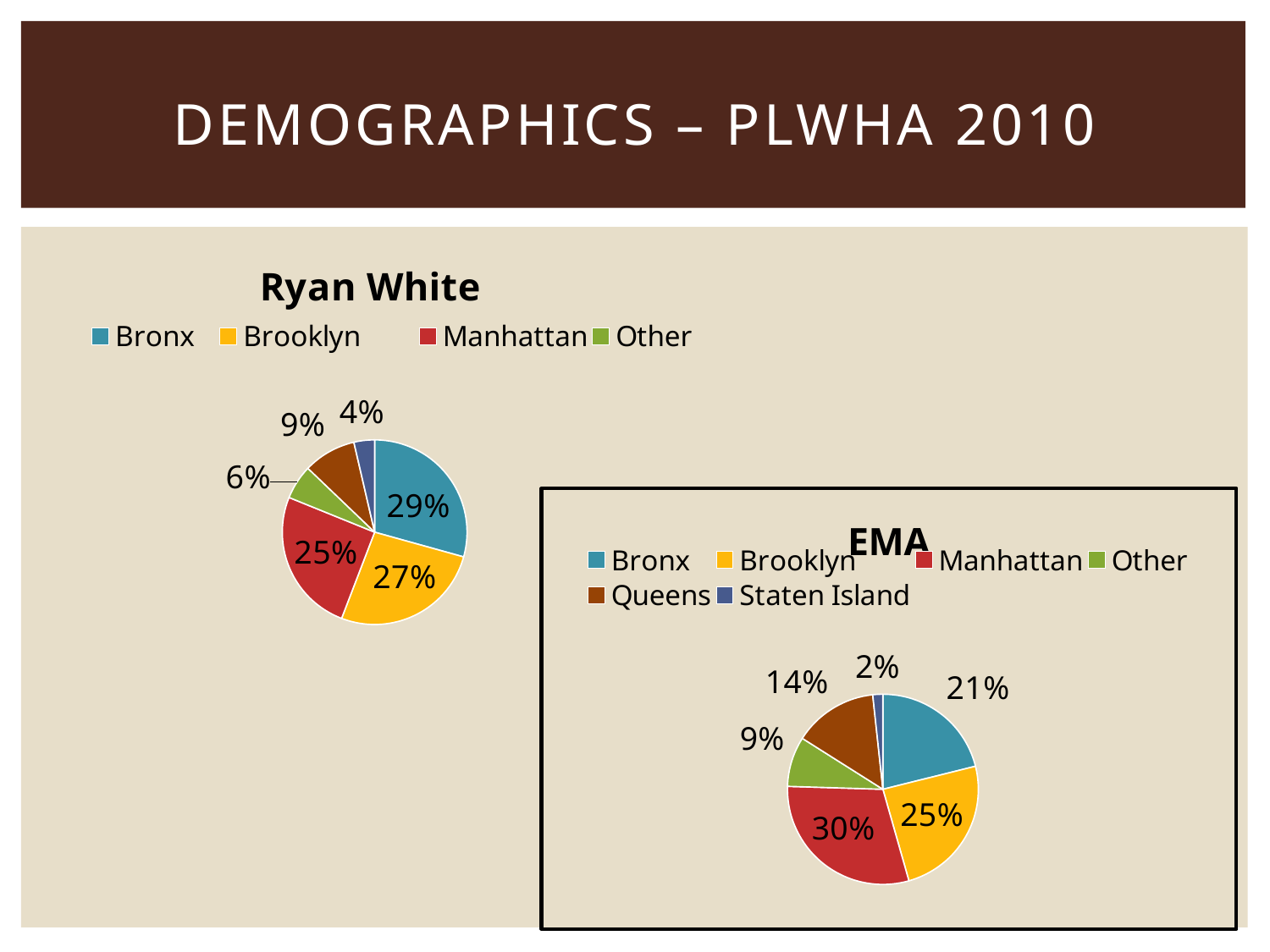
In the EMA pie chart, what share is Queens? 14% In the EMA pie chart, which borough has the largest share? Manhattan In the Ryan White pie chart, which category has the largest share? Bronx In the EMA pie chart, what is the difference between the Manhattan and Bronx shares? 9% In the EMA pie chart, what share is Staten Island? 2% In the Ryan White pie chart, what share is Bronx? 29% In the Ryan White pie chart, what share is Manhattan? 25% In the Ryan White pie chart, which is larger, the Brooklyn share or the Other share? Brooklyn What type of chart is the EMA chart? Pie chart In the EMA pie chart, which category has the smallest share? Staten Island In the EMA pie chart, what share is Manhattan? 30% How many entries does the legend of the EMA chart list? 6